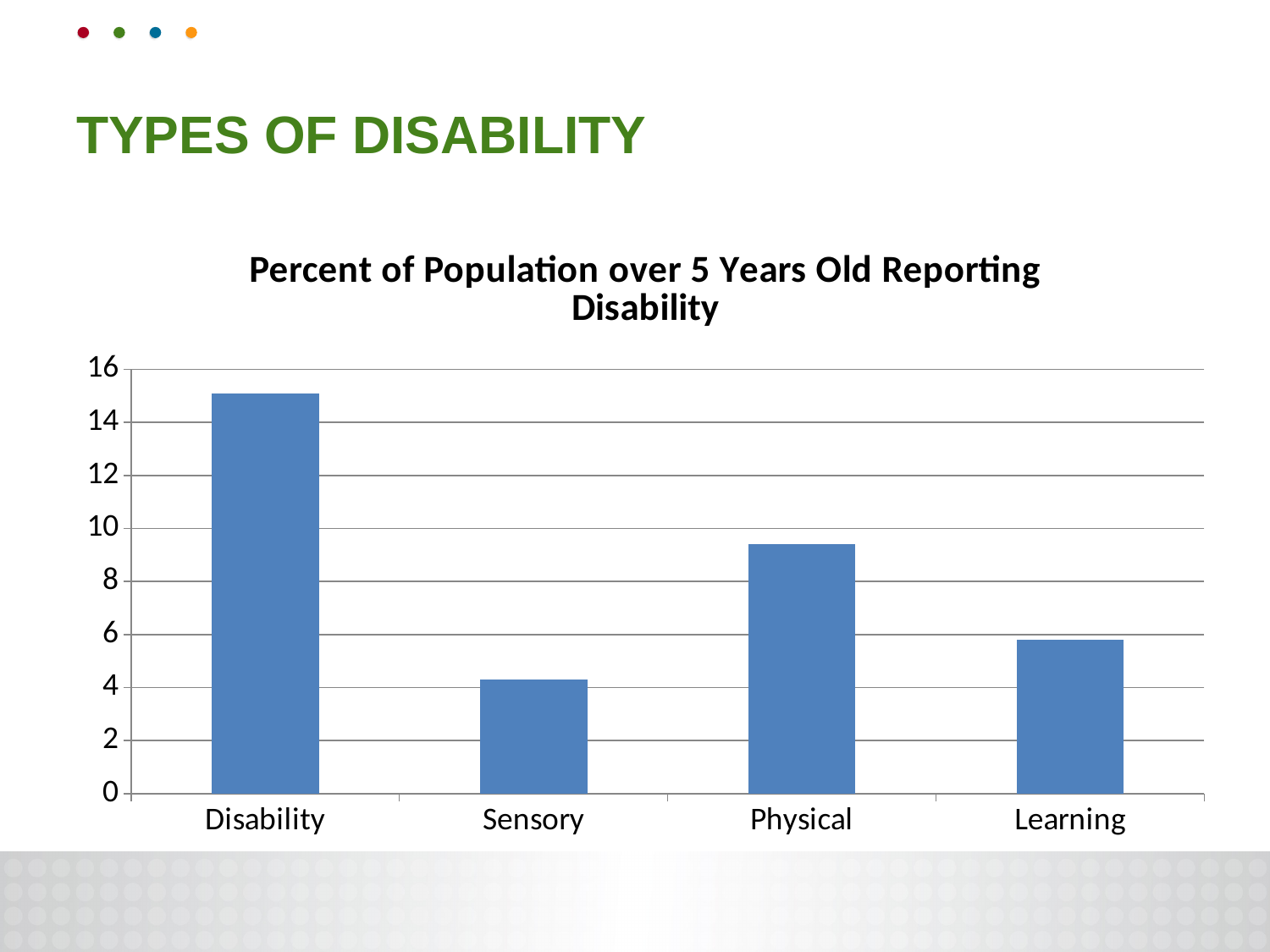
Which category has the lowest value? Sensory Is the value for Sensory greater or less than 6? less Which category has the highest value? Disability Is the value for Physical greater or less than 10? less Which is larger, the value for Physical or the value for Learning? Physical Which is larger, the value for Sensory or the value for Learning? Learning How many categories are shown on the x axis of the chart? 4 Is the value for Disability greater or less than 14? greater What kind of chart is shown on the slide? bar chart What is the title of the chart? Percent of Population over 5 Years Old Reporting Disability